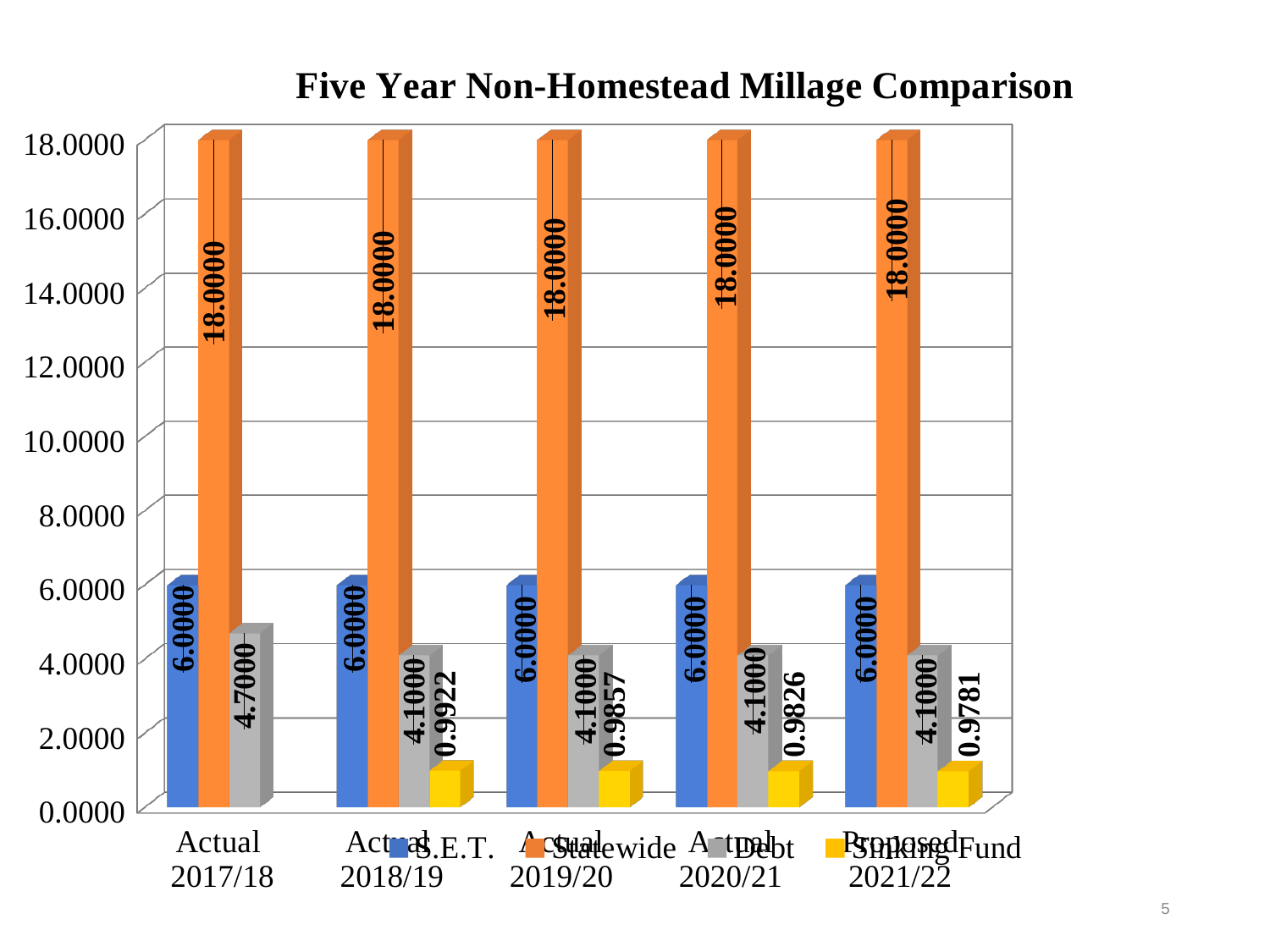
Which is larger for Actual 2020/21, the S.E.T. value or the Debt value? S.E.T. What kind of chart is shown on the slide? Bar chart Do the Sinking Fund values rise or fall from Actual 2018/19 to Proposed 2021/22? Fall What is the Debt value for Actual 2017/18? 4.7000 Which year has the highest Debt value? Actual 2017/18 What is the Sinking Fund value for Actual 2018/19? 0.9922 How many series does the legend list? 4 What is the Statewide value for Actual 2019/20? 18.0000 What is the Sinking Fund value for Proposed 2021/22? 0.9781 What is the difference between the Debt value for Actual 2017/18 and the Debt value for Actual 2018/19? 0.6000 How many year categories are shown on the x axis? 5 Which year has the lowest Sinking Fund value? Proposed 2021/22